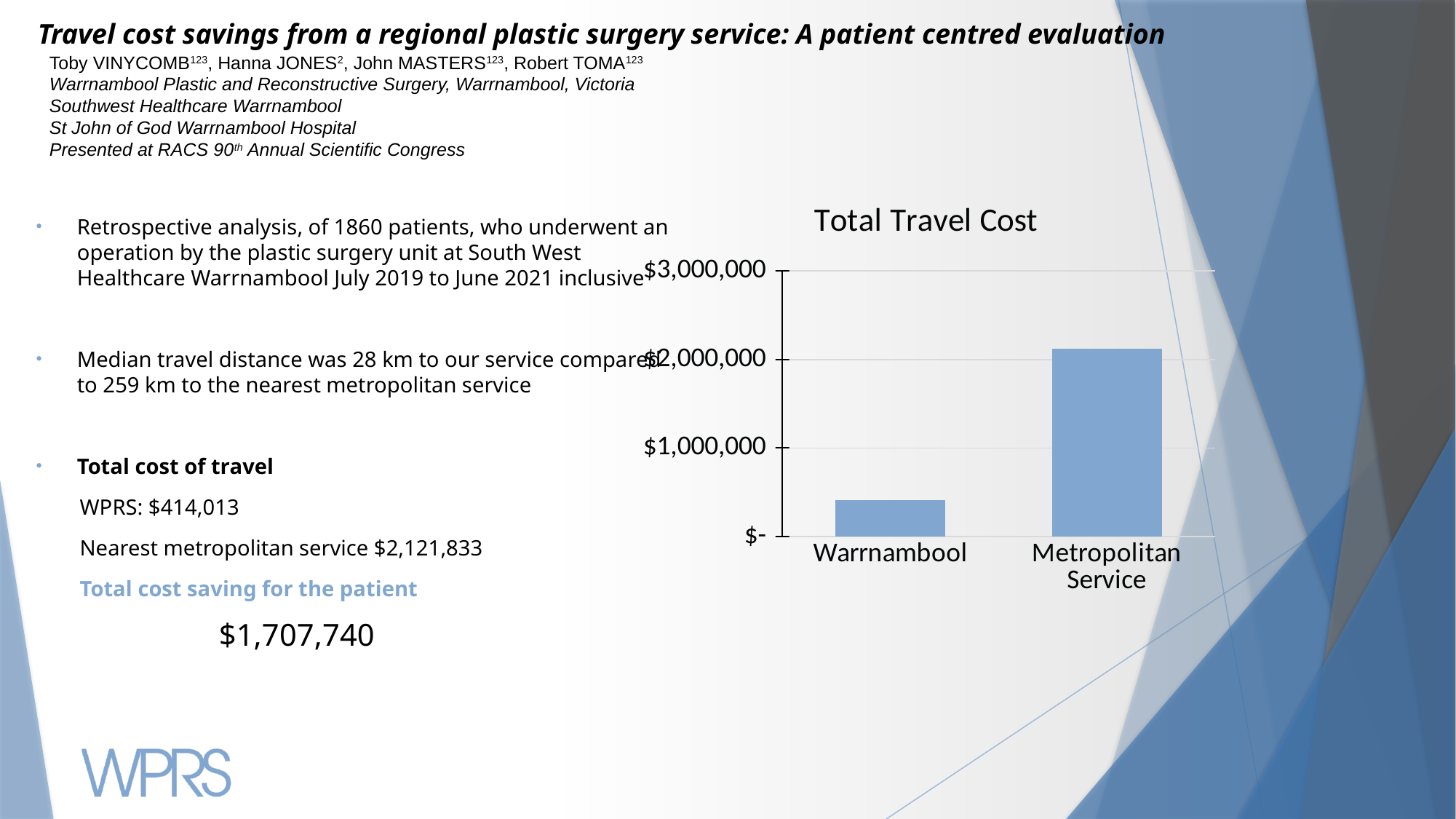
Which is larger, the total travel cost for Warrnambool or for Metropolitan Service? Metropolitan Service Is the total travel cost for Metropolitan Service greater or less than $2,000,000? greater Is the total travel cost for Warrnambool greater or less than $1,000,000? less What is the title of the chart? Total Travel Cost Which category has the highest total travel cost in the chart? Metropolitan Service What is the highest value labelled on the y axis of the chart? $3,000,000 How many categories are shown on the x axis of the chart? 2 Do the bar values rise or fall from Warrnambool to Metropolitan Service along the x axis? rise What type of chart is shown on the slide? bar chart Which category has the lowest total travel cost in the chart? Warrnambool Is the total travel cost for Metropolitan Service greater or less than $3,000,000? less